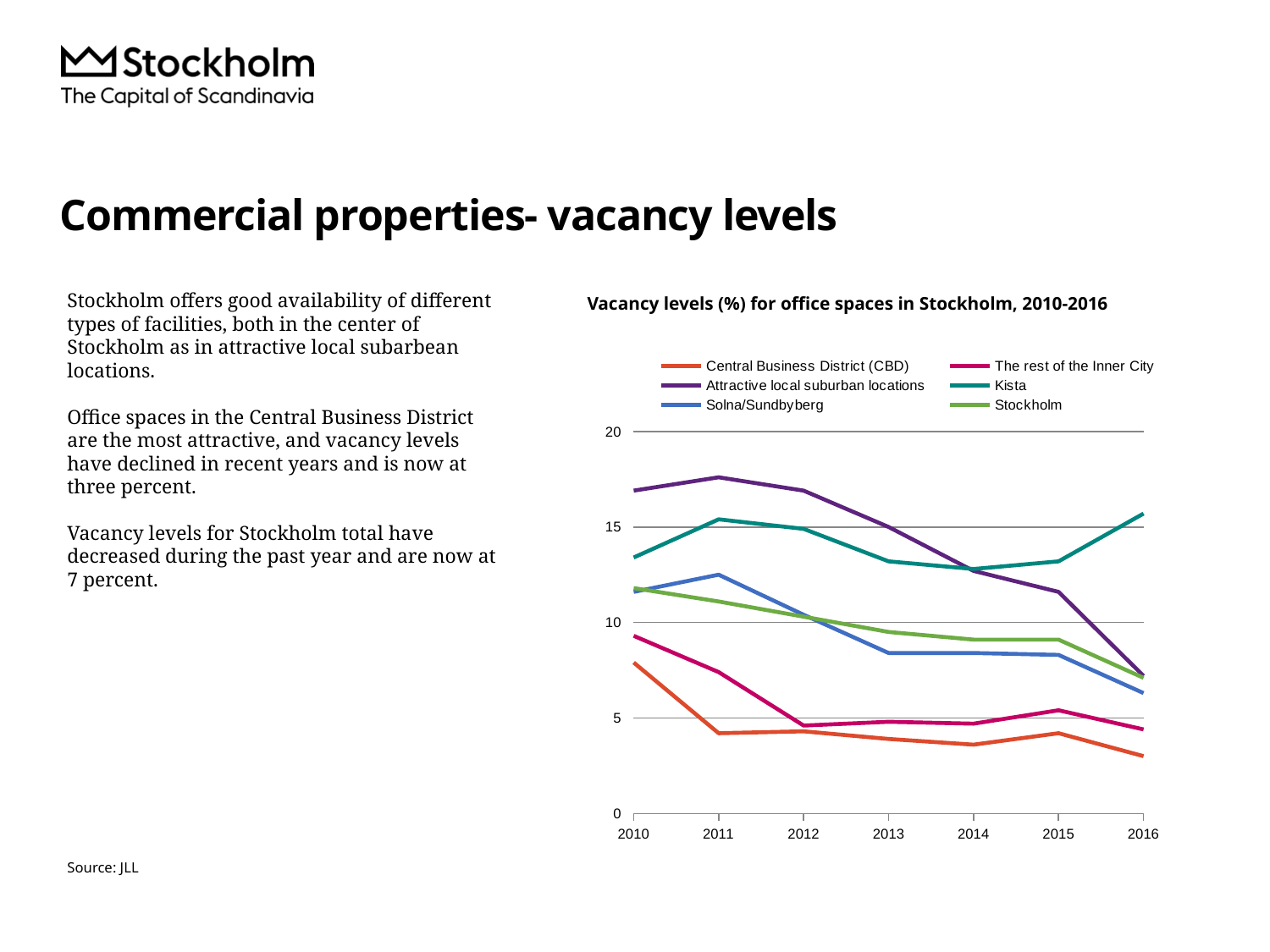
Is the vacancy level for Kista in 2016 greater or less than 15? greater How many series does the chart legend list? 6 What kind of chart is shown on the slide? Line chart What is the title of the chart? Vacancy levels (%) for office spaces in Stockholm, 2010-2016 Which series has the highest vacancy level in 2016? Kista Is the vacancy level for Solna/Sundbyberg in 2010 greater or less than 10? greater How many years are plotted along the x axis of the chart? 7 Which series has the highest vacancy level in 2010? Attractive local suburban locations In 2011, which has the higher vacancy level: the Central Business District (CBD) or The rest of the Inner City? The rest of the Inner City Does the vacancy level for the Central Business District (CBD) rise or fall from 2010 to 2016? Fall Which series has the lowest vacancy level in 2016? Central Business District (CBD) Is the vacancy level for the Central Business District (CBD) in 2016 greater or less than 5? less